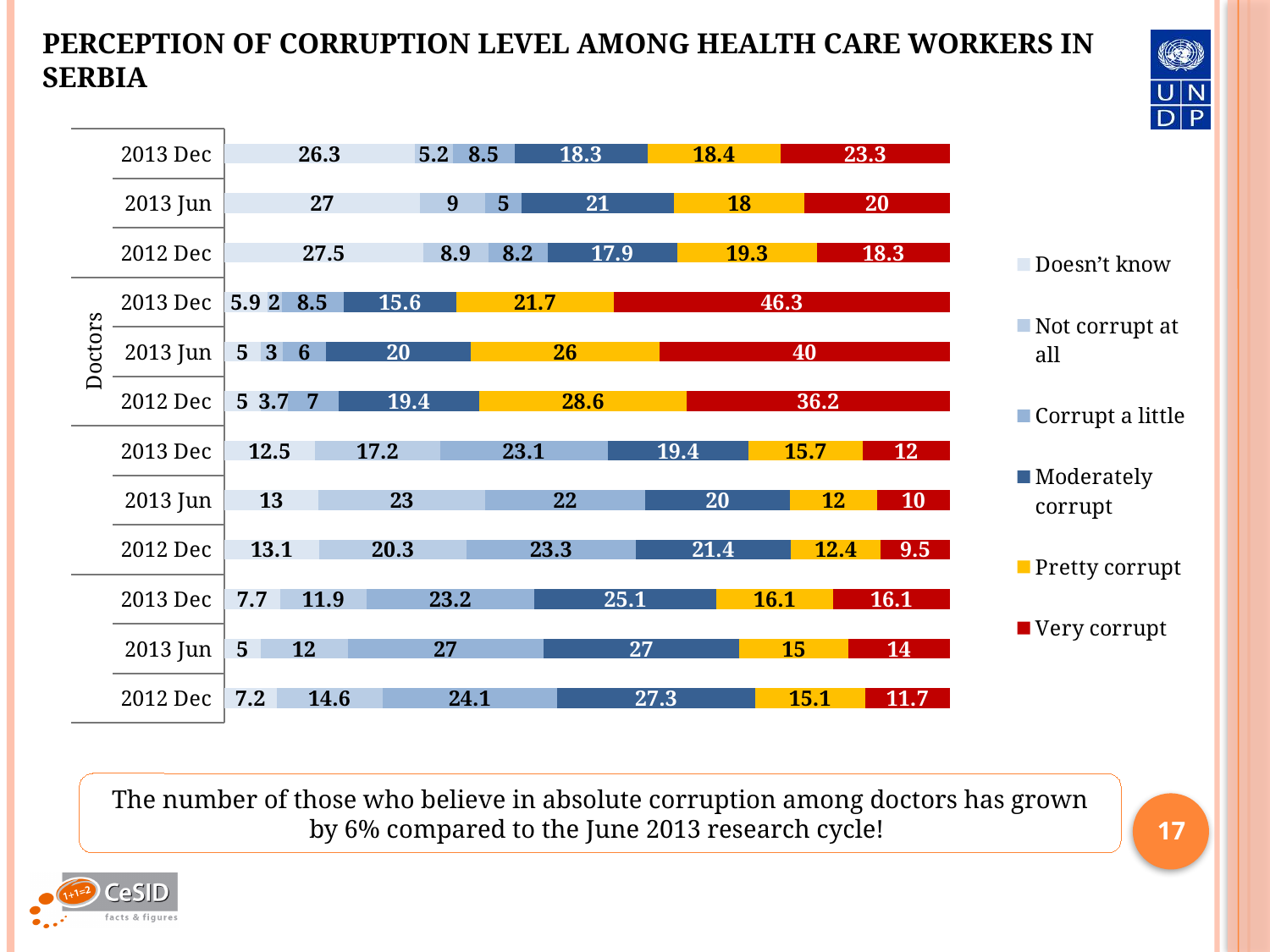
What is the total of the Doctors 2013 Jun stacked bar? 100 In the Doctors group, what is the 'Pretty corrupt' value for 2012 Dec? 28.6 In the Doctors group, does the 'Very corrupt' value rise or fall from 2012 Dec through 2013 Jun to 2013 Dec? Rises In the Doctors group for 2013 Jun, which is larger: 'Pretty corrupt' or 'Moderately corrupt'? Pretty corrupt How many bars are plotted in the chart in total? 12 In the Doctors group, by how much does the 'Very corrupt' value for 2013 Dec exceed that for 2013 Jun? 6.3 In the Doctors group, which period has the highest 'Very corrupt' value? 2013 Dec What colour represents 'Very corrupt' in the legend? Red How many series does the legend list? 6 What kind of chart is shown on the slide? Stacked bar chart In the Doctors group, what is the 'Moderately corrupt' value for 2013 Jun? 20 In the Doctors group, what is the 'Very corrupt' value for 2013 Dec? 46.3